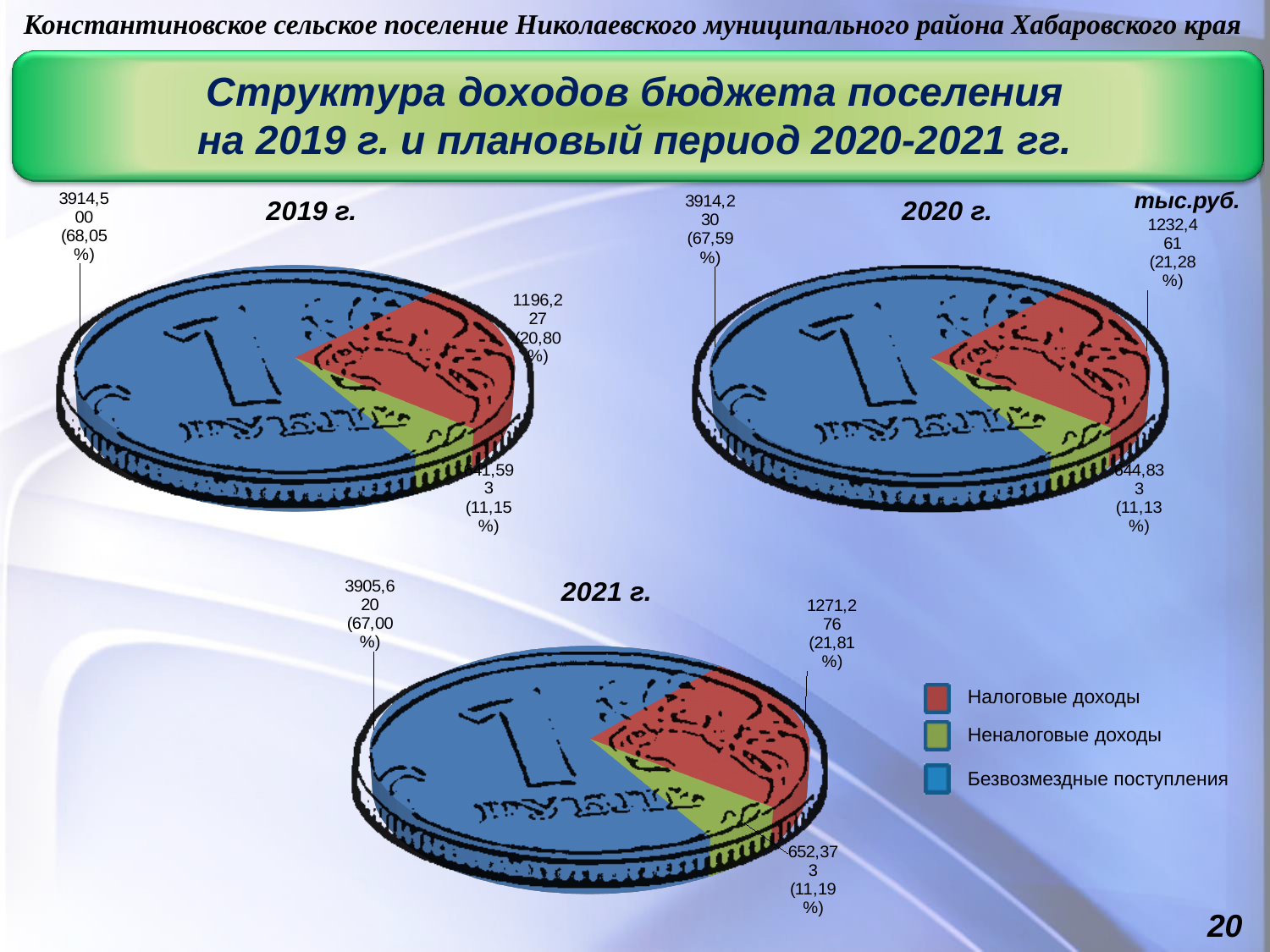
In the 2020 г. chart, which category has the smallest slice? Неналоговые доходы In the 2021 г. chart, what is the value for Неналоговые доходы? 652,373 In the 2021 г. chart, what share of the pie is Налоговые доходы? 21,81% What unit of measurement is indicated on the slide for the chart values? тыс.руб. In the 2019 г. chart, what is the value for Налоговые доходы? 1196,227 In the 2020 г. chart, what is the value for Безвозмездные поступления? 3914,230 In the 2019 г. chart, what share of the pie is Безвозмездные поступления? 68,05% What kind of chart is used for the 2019 г. chart? pie chart In the 2021 г. chart, which is larger: Налоговые доходы or Неналоговые доходы? Налоговые доходы In the 2021 г. chart, which category has the largest slice? Безвозмездные поступления How many entries does the legend list? 3 In the 2020 г. chart, what share of the pie is Неналоговые доходы? 11,13%